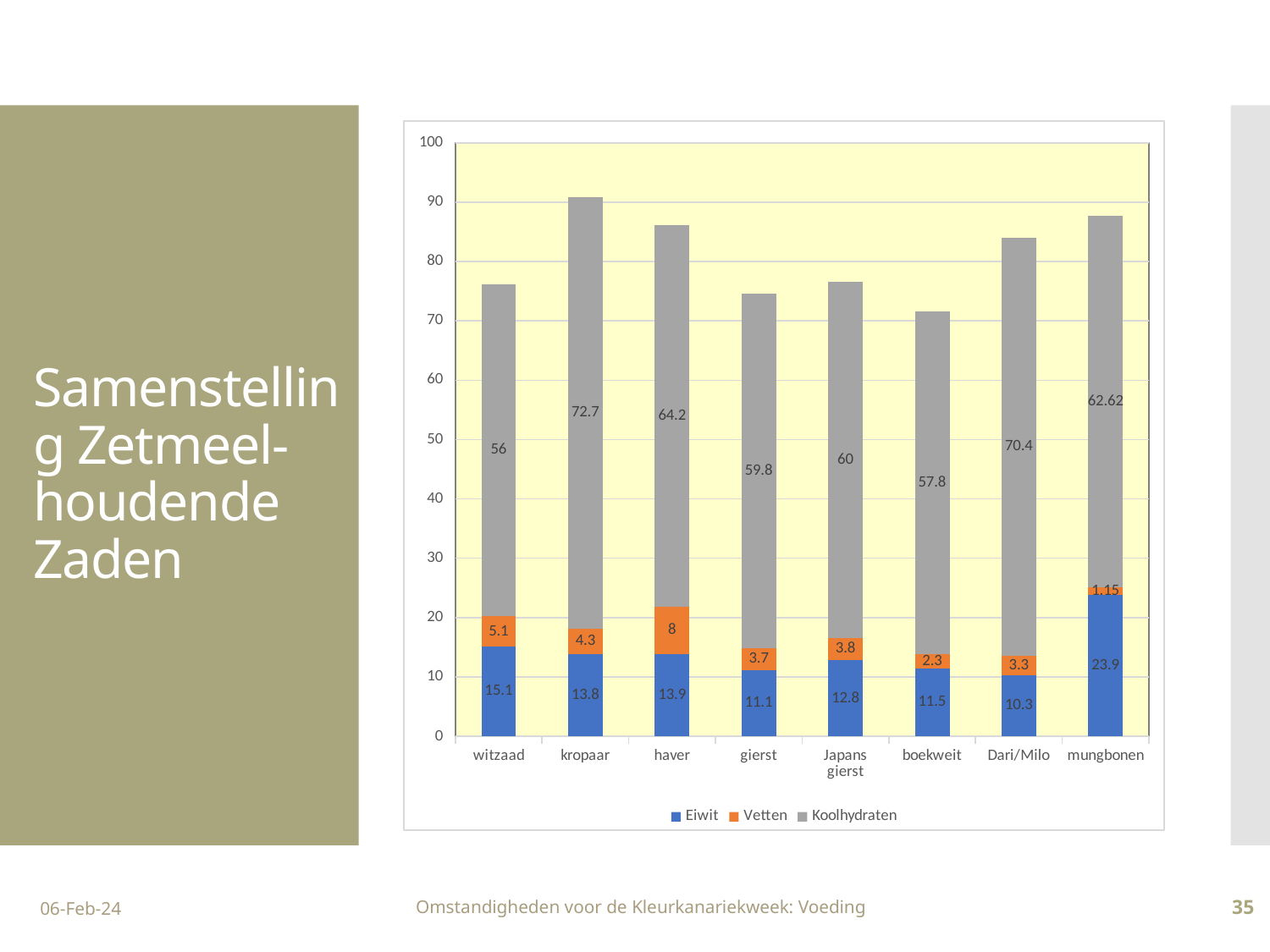
What is the total of the stacked bar for witzaad? 76.2 What is the Vetten value for haver? 8 Which is larger, the Eiwit value for gierst or the Eiwit value for boekweit? boekweit How many categories are shown on the x axis? 8 What is the Eiwit value for mungbonen? 23.9 What type of chart is shown on the slide? stacked bar chart Which category has the lowest Vetten value? mungbonen Which category has the highest Eiwit value? mungbonen How many series does the legend list? 3 Which series is shown in orange in the legend? Vetten What is the difference between the Koolhydraten values for Dari/Milo and witzaad? 14.4 What is the Koolhydraten value for kropaar? 72.7